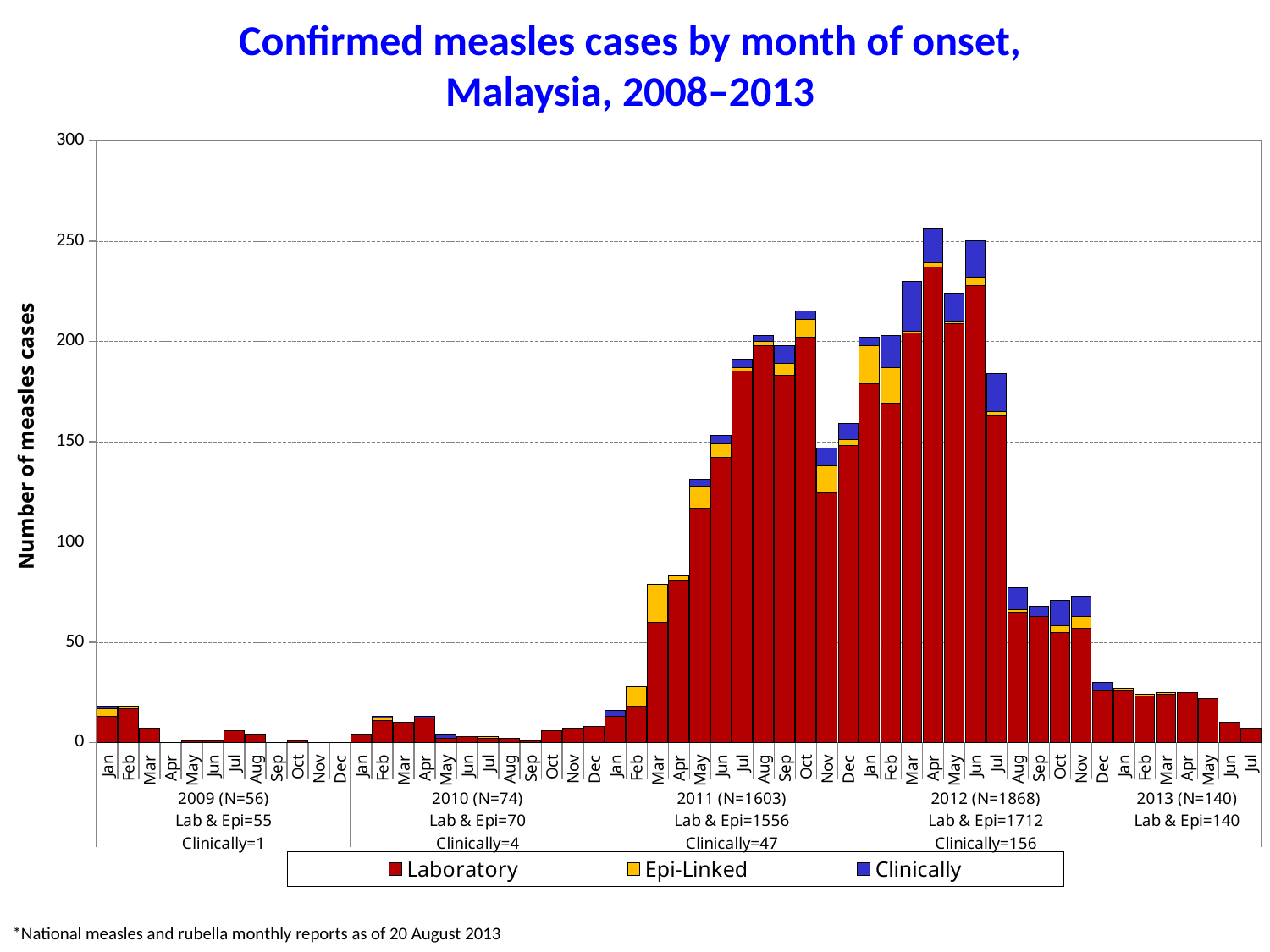
What is the difference between the total N for 2012 and the total N for 2011? 265 Which is larger, the Lab & Epi count for 2010 or the Lab & Epi count for 2013? 2013 (Lab & Epi=140) What are the three series named in the legend? Laboratory, Epi-Linked, Clinically How many cases were classified as Clinically confirmed in 2011? 47 Is the total stacked value for Mar 2011 greater or less than 100? less What kind of chart is shown on the slide? stacked bar chart Which year has the highest total N of confirmed measles cases? 2012 (N=1868) Is the total stacked value for Apr 2012 greater or less than 250? greater How many series does the legend list? 3 What is the total number of confirmed measles cases (N) shown for 2012? 1868 Which year has the lowest total N of confirmed measles cases? 2009 (N=56) What is the title of the chart? Confirmed measles cases by month of onset, Malaysia, 2008–2013